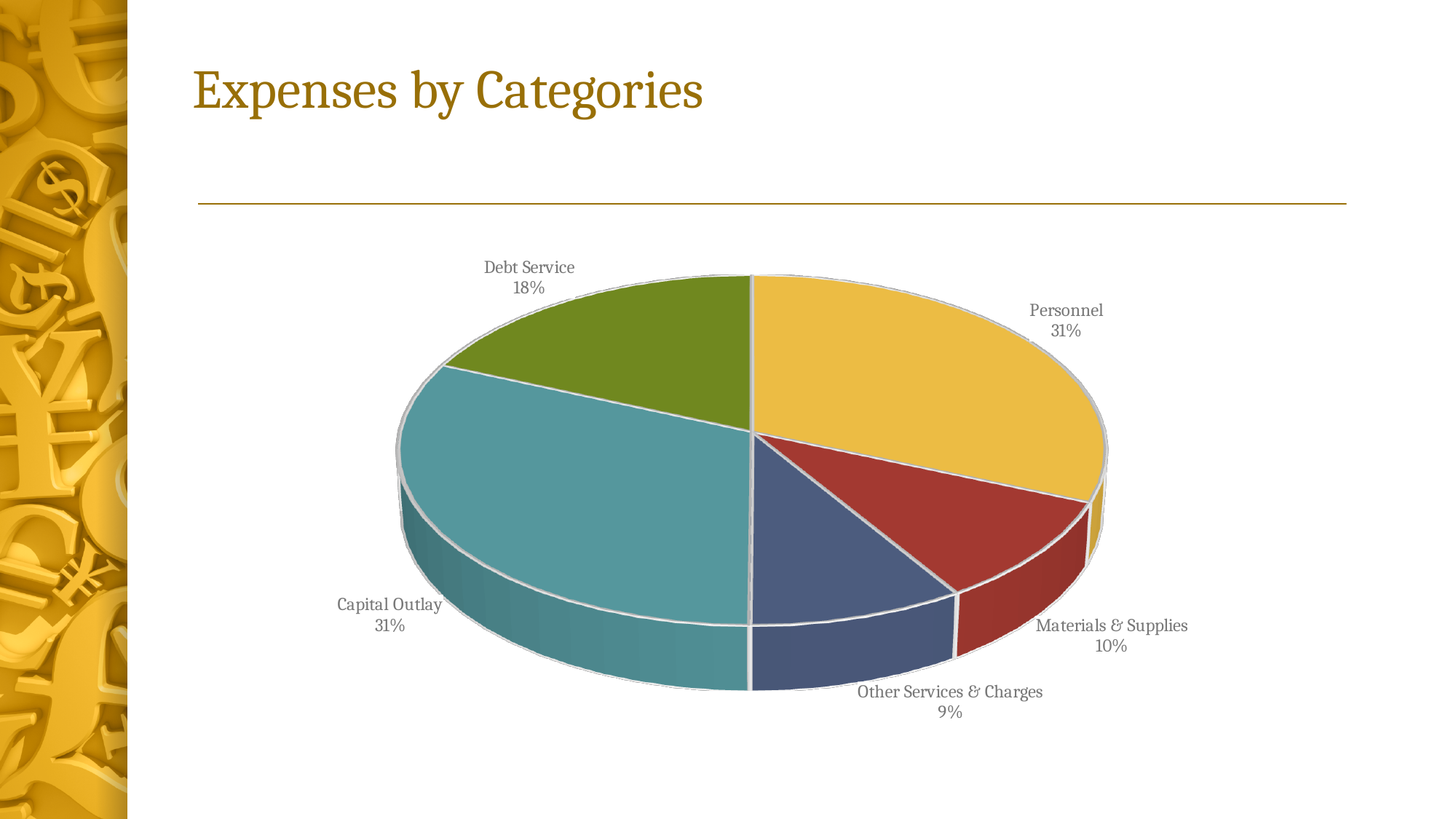
What is the difference in percentage points between Capital Outlay and Debt Service? 13 Which category has the smallest share of expenses? Other Services & Charges What share of expenses is Materials & Supplies? 10% What colour is the Capital Outlay slice? Teal How many categories are shown in the pie chart? 5 What kind of chart is shown on the slide? Pie chart What share of expenses is Capital Outlay? 31% Which is larger, the share for Debt Service or the share for Materials & Supplies? Debt Service What share of expenses is Debt Service? 18% What is the title of the chart on the slide? Expenses by Categories